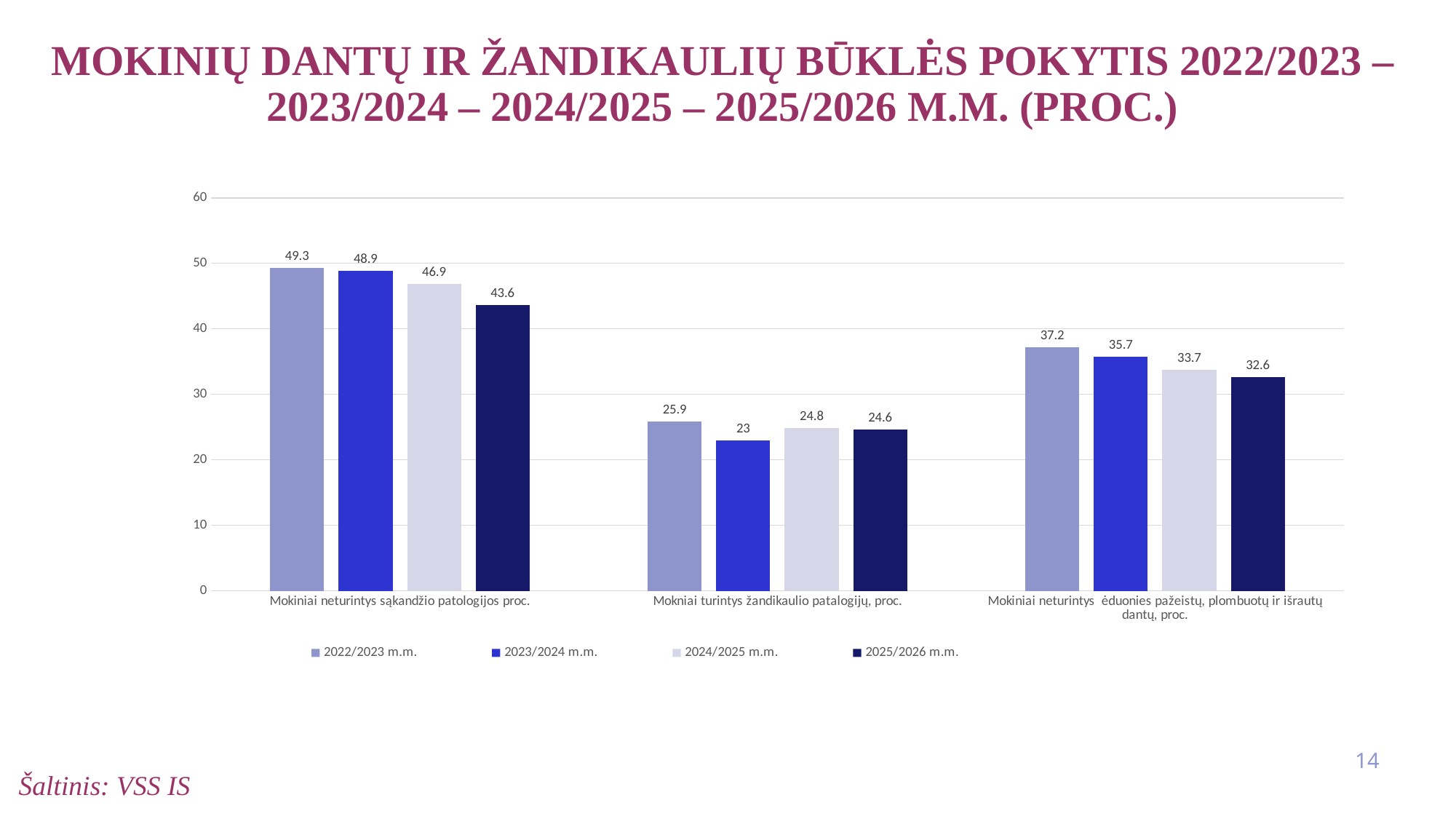
Is the value for 2023/2024 m.m. in the category 'Mokiniai neturintys sąkandžio patologijos proc.' greater or less than 40? greater What is the value for 2025/2026 m.m. in the category 'Mokniai turintys žandikaulio patalogijų, proc.'? 24.6 What kind of chart is shown on the slide? bar chart How many categories are shown on the x axis? 3 Do the values for the category 'Mokiniai neturintys sąkandžio patologijos proc.' rise or fall from 2022/2023 m.m. to 2025/2026 m.m.? fall What is the value for 2022/2023 m.m. in the category 'Mokiniai neturintys sąkandžio patologijos proc.'? 49.3 How many series does the legend list? 4 Which series has the highest value in the category 'Mokiniai neturintys ėduonies pažeistų, plombuotų ir išrautų dantų, proc.'? 2022/2023 m.m. Which series has the lowest value in the category 'Mokniai turintys žandikaulio patalogijų, proc.'? 2023/2024 m.m. What is the value for 2024/2025 m.m. in the category 'Mokiniai neturintys ėduonies pažeistų, plombuotų ir išrautų dantų, proc.'? 33.7 Which is larger in the category 'Mokiniai neturintys ėduonies pažeistų, plombuotų ir išrautų dantų, proc.': the 2023/2024 m.m. value or the 2025/2026 m.m. value? 2023/2024 m.m. What is the difference between the 2022/2023 m.m. and 2025/2026 m.m. values in the category 'Mokiniai neturintys sąkandžio patologijos proc.'? 5.7